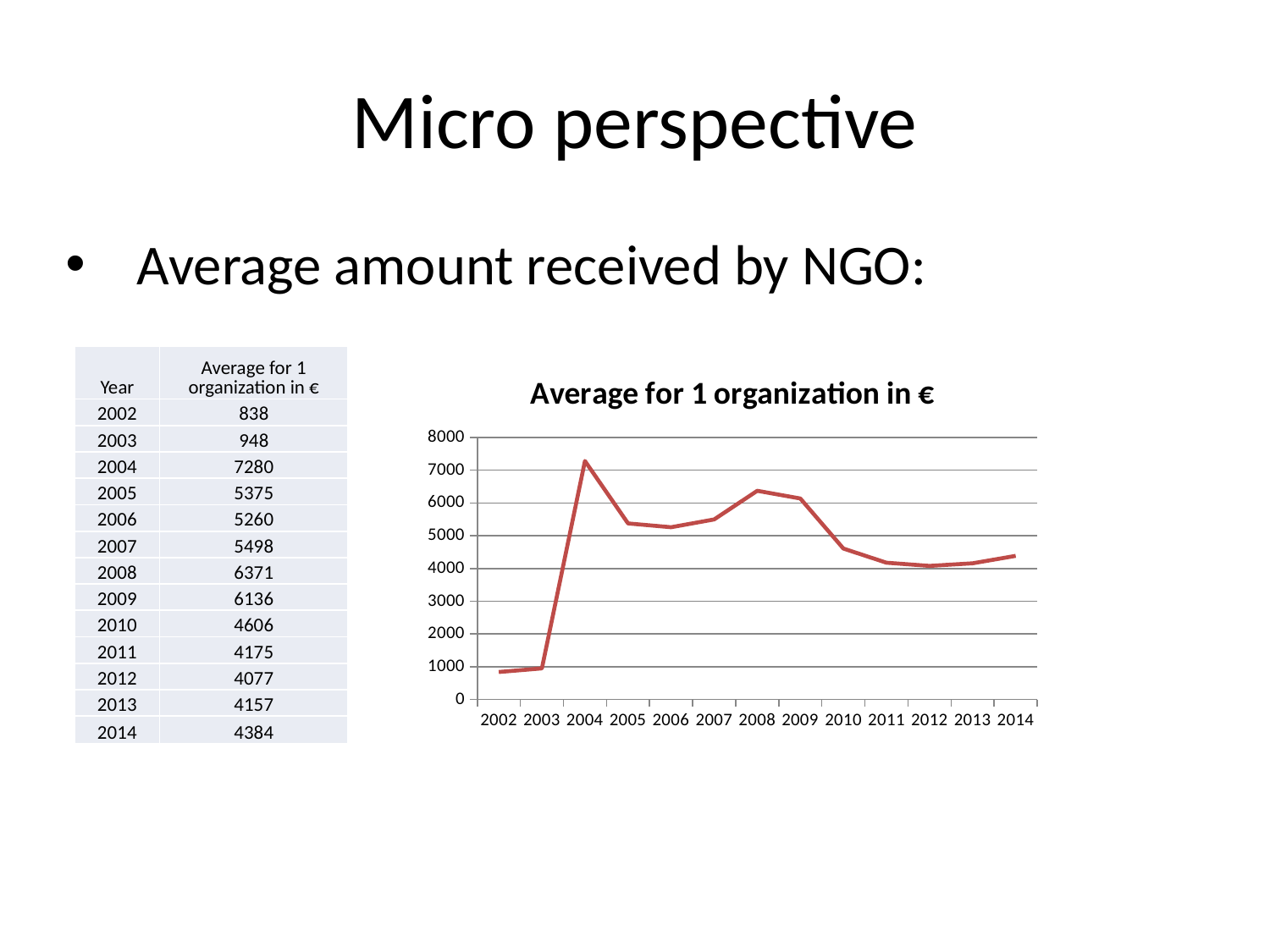
Is the value for 2003 greater or less than 1000? less What is the difference between the values for 2004 and 2005? 1905 What is the title of the chart? Average for 1 organization in € Which year has the highest average for 1 organization? 2004 What is the average for 1 organization in € in 2004? 7280 Which is larger, the value for 2008 or the value for 2010? 2008 Which year has the lowest average for 1 organization? 2002 Does the value rise or fall from 2009 to 2012? fall How many years are plotted on the x axis of the chart? 13 Is the value for 2004 greater or less than 7000? greater What is the average for 1 organization in € in 2012? 4077 What type of chart is shown on the slide? line chart